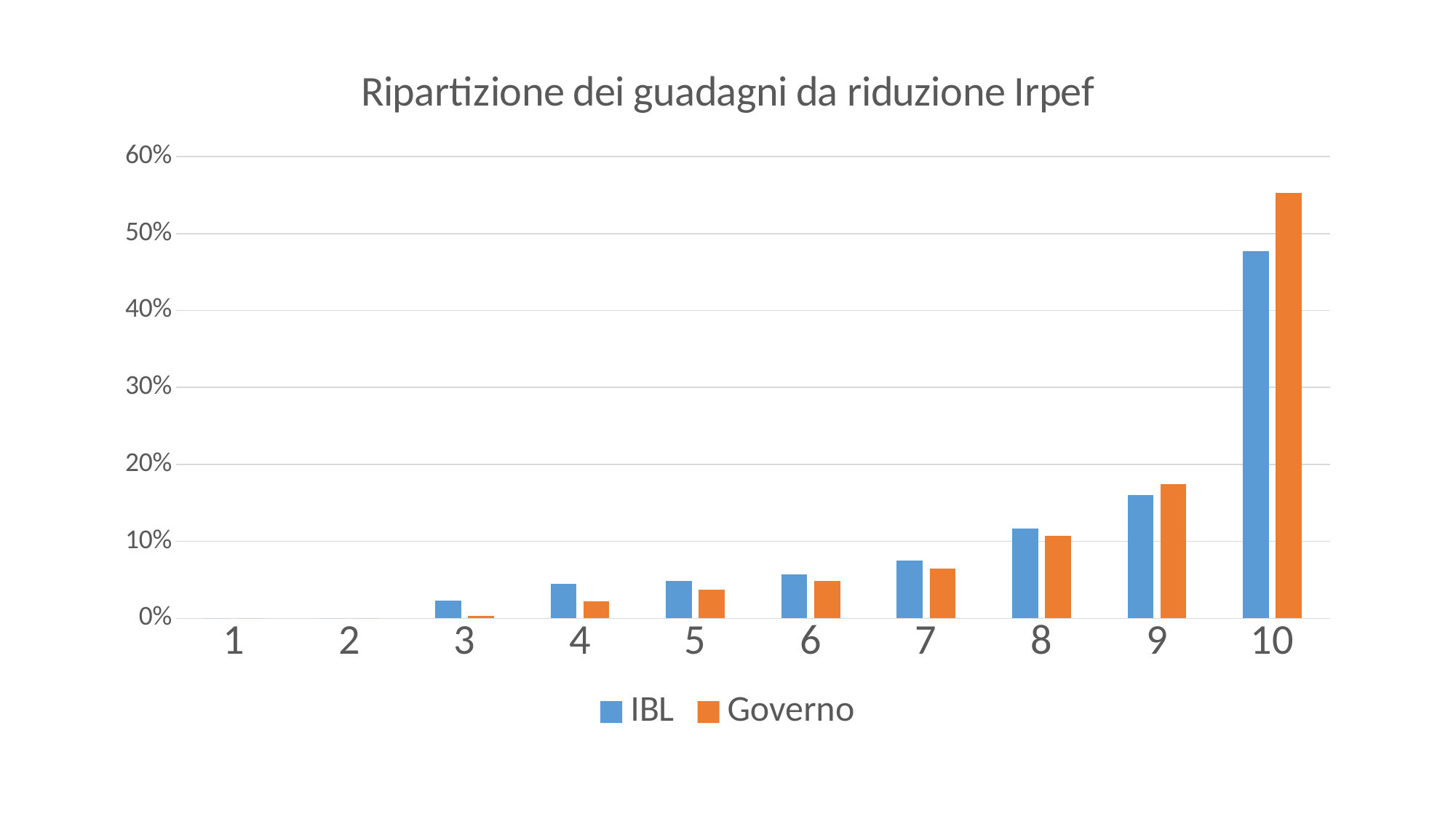
For category 10, which series has the larger value, IBL or Governo? Governo Is the Governo value for category 10 greater or less than 50%? greater Which category has the highest Governo value? 10 Is the IBL value for category 10 greater or less than 50%? less What kind of chart is shown on the slide? bar chart For category 8, which series has the larger value, IBL or Governo? IBL Do the values generally rise or fall from category 1 to category 10? rise How many series does the legend list? 2 Which category has the highest IBL value? 10 Is the IBL value for category 9 greater or less than 20%? less How many categories are shown on the x axis? 10 What is the title of the chart? Ripartizione dei guadagni da riduzione Irpef